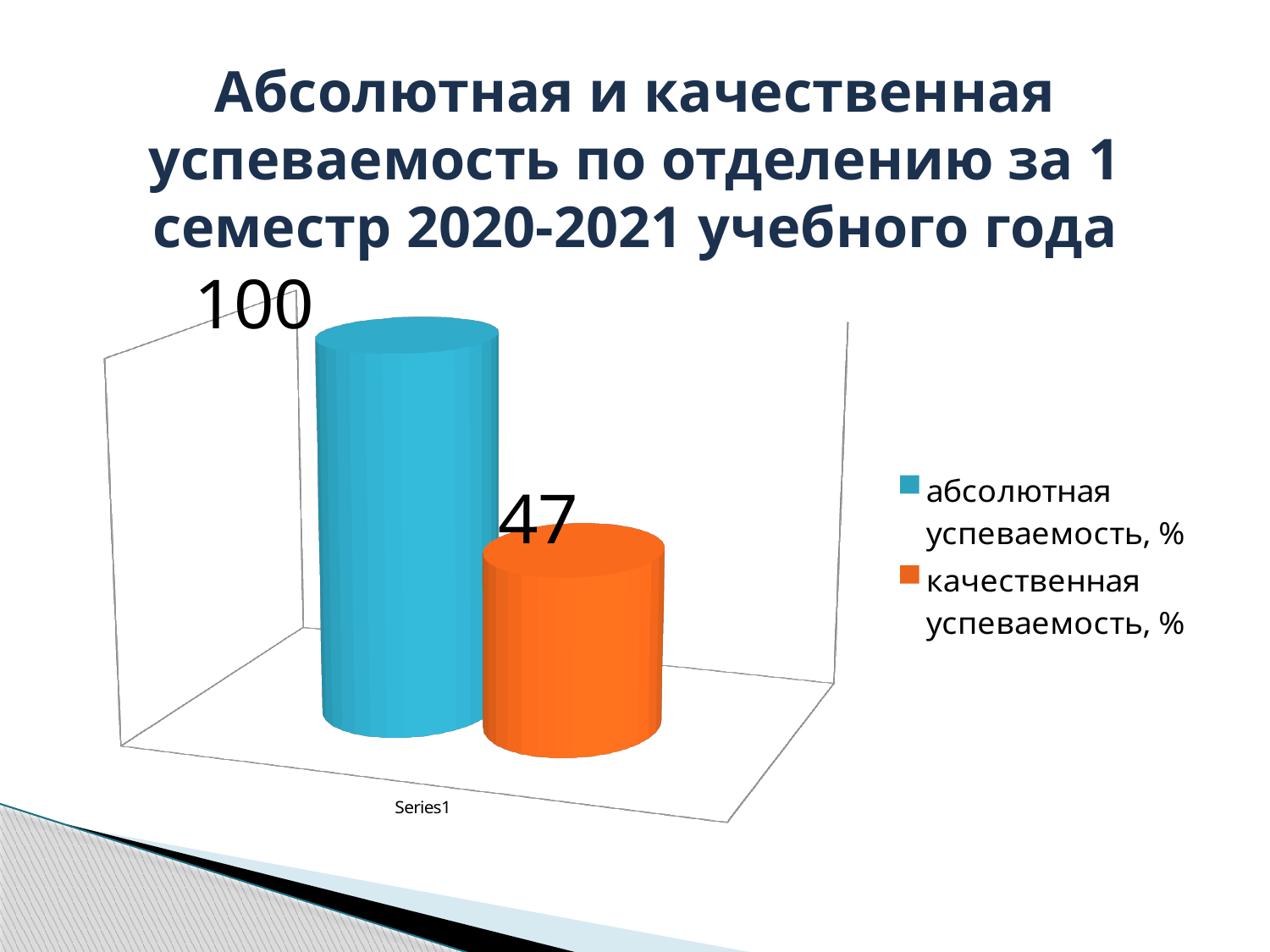
What is the value for качественная успеваемость, %? 47 Is the value for качественная успеваемость larger or smaller than the value for абсолютная успеваемость? smaller Which series has the lower value? качественная успеваемость, % What kind of chart is shown on the slide? bar chart What is the category label shown on the x axis? Series1 Which series has the higher value, абсолютная успеваемость or качественная успеваемость? абсолютная успеваемость, % What is the difference between абсолютная успеваемость and качественная успеваемость? 53 How many bars are plotted on the chart? 2 How many series does the legend list? 2 What is the value for абсолютная успеваемость, %? 100 What colour is the bar for качественная успеваемость, %? orange